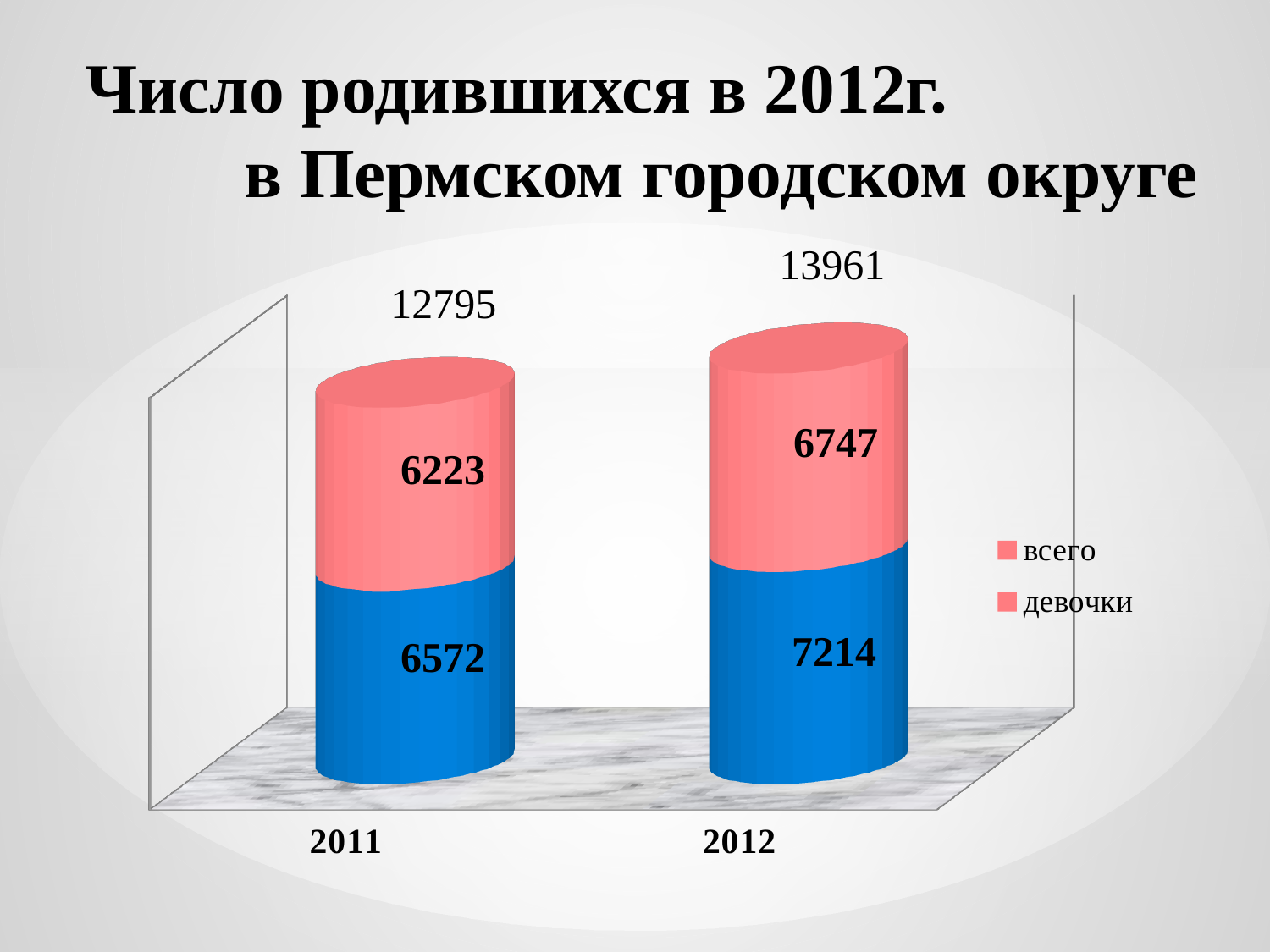
What is the value of the blue segment for 2012? 7214 What is the value of the blue segment for 2011? 6572 Which year has the higher total? 2012 What is the value of the pink segment for 2011? 6223 What is the total shown above the bar for 2011? 12795 What is the value of the pink segment for 2012? 6747 What type of chart is shown on the slide? bar chart How many categories are shown on the x axis of the chart? 2 What is the total shown above the bar for 2012? 13961 How many entries does the chart's legend list? 2 Do the totals rise or fall from 2011 to 2012? rise What is the difference between the blue segment values for 2012 and 2011? 642